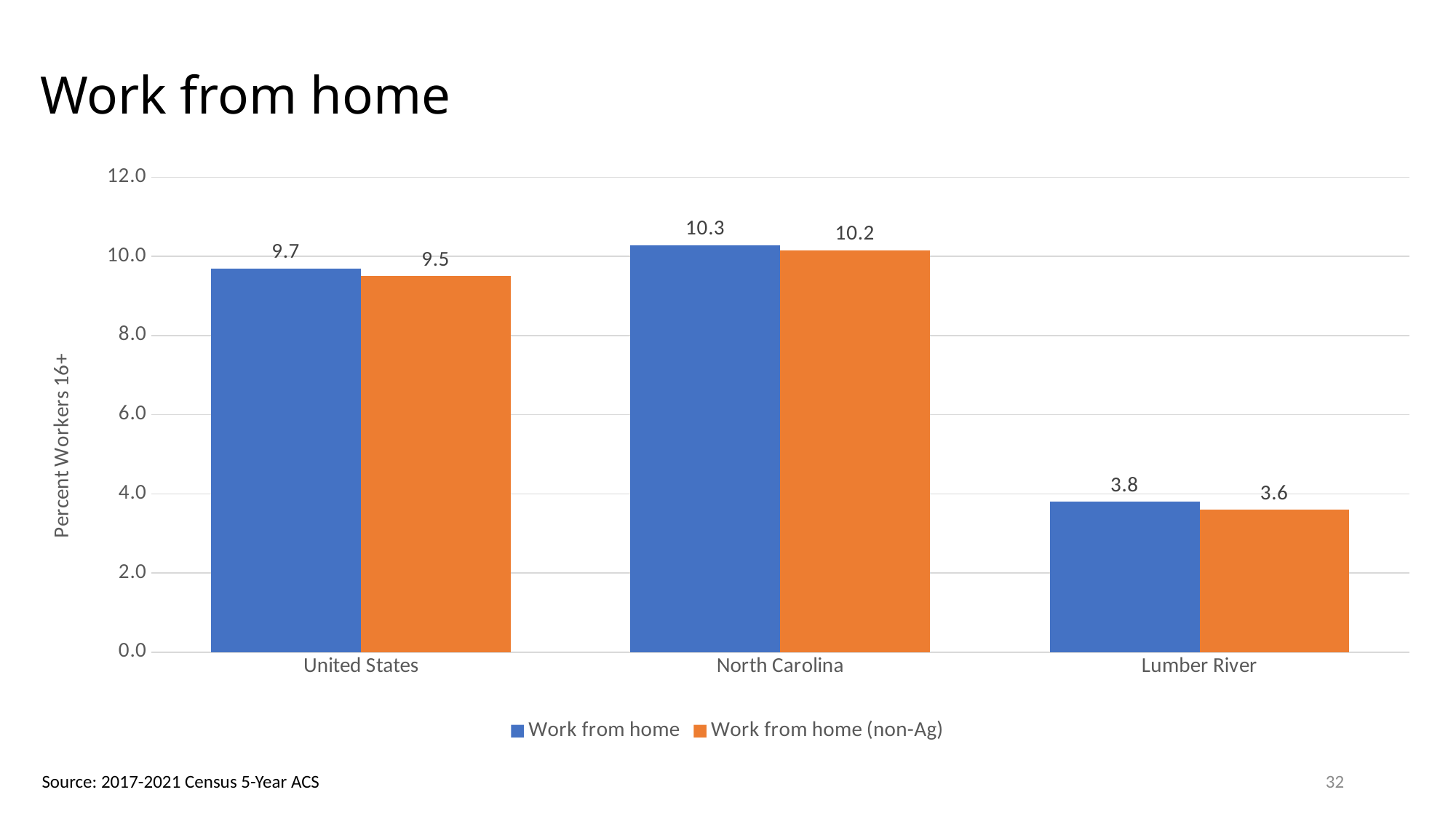
What is the 'Work from home' value for North Carolina? 10.3 How many regions are shown on the x axis? 3 Which is larger: the 'Work from home' value for the United States or for Lumber River? United States Which region has the lowest 'Work from home (non-Ag)' value? Lumber River What kind of chart is shown on the slide? Bar chart Is the 'Work from home (non-Ag)' value for the United States greater or less than 8.0? greater What is the 'Work from home (non-Ag)' value for Lumber River? 3.6 What is the label on the vertical axis? Percent Workers 16+ What is the difference between the 'Work from home' values for North Carolina and Lumber River? 6.5 Which region has the highest 'Work from home' value? North Carolina What is the 'Work from home' value for the United States? 9.7 How many series does the legend list? 2